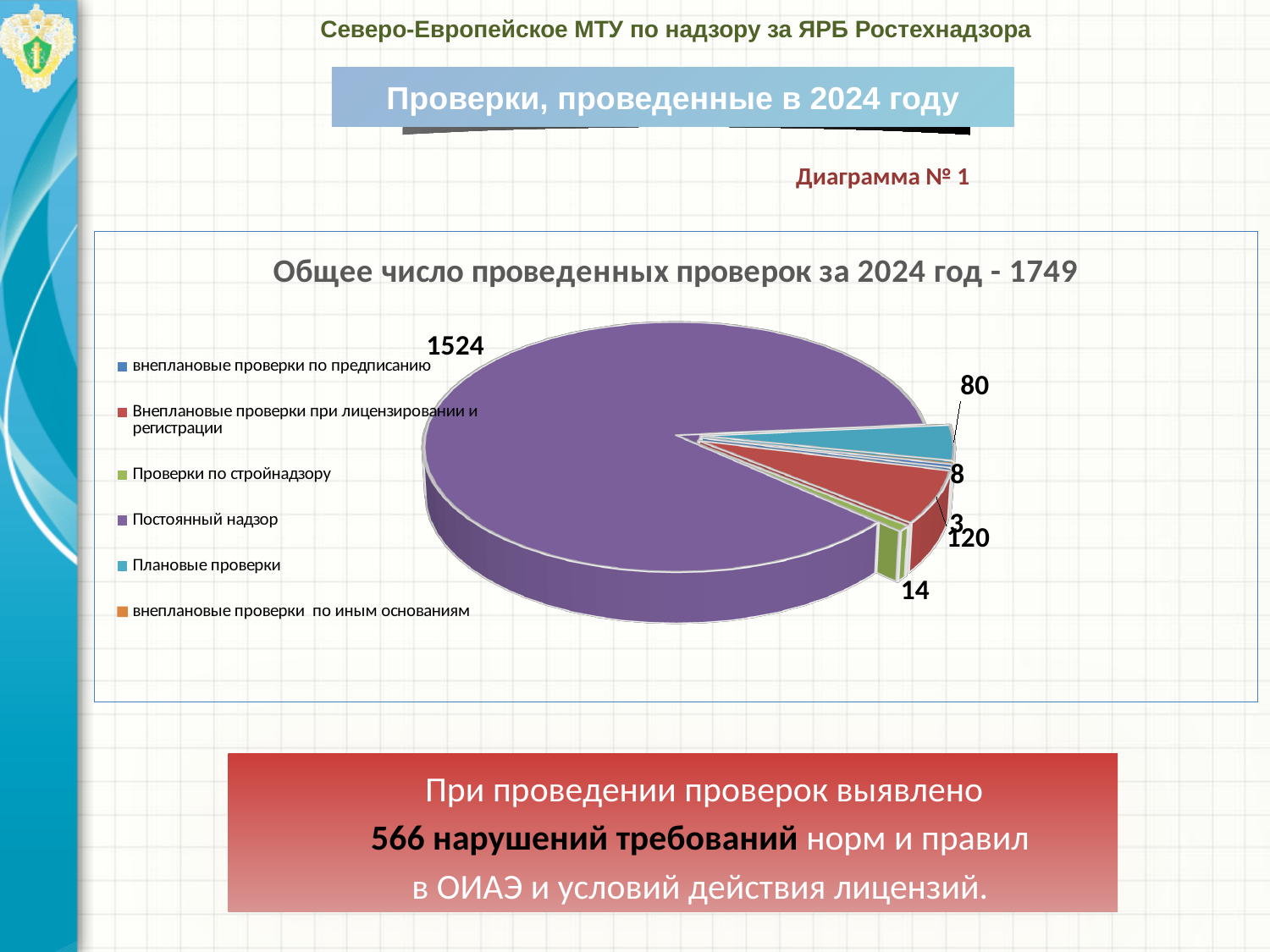
What is the value for Постоянный надзор? 1524 What total number of inspections for 2024 is stated in the chart title? 1749 What is the smallest value labelled on the pie chart? 3 What is the difference between the values for Постоянный надзор and Внеплановые проверки при лицензировании и регистрации? 1404 What colour is the slice for Постоянный надзор? purple What type of chart is shown on the slide? pie chart What is the value for Проверки по стройнадзору? 14 How many categories does the legend list? 6 What is the value for Плановые проверки? 80 Which category has the largest slice of the pie? Постоянный надзор What is the value for Внеплановые проверки при лицензировании и регистрации? 120 Which is larger: Плановые проверки or Проверки по стройнадзору? Плановые проверки